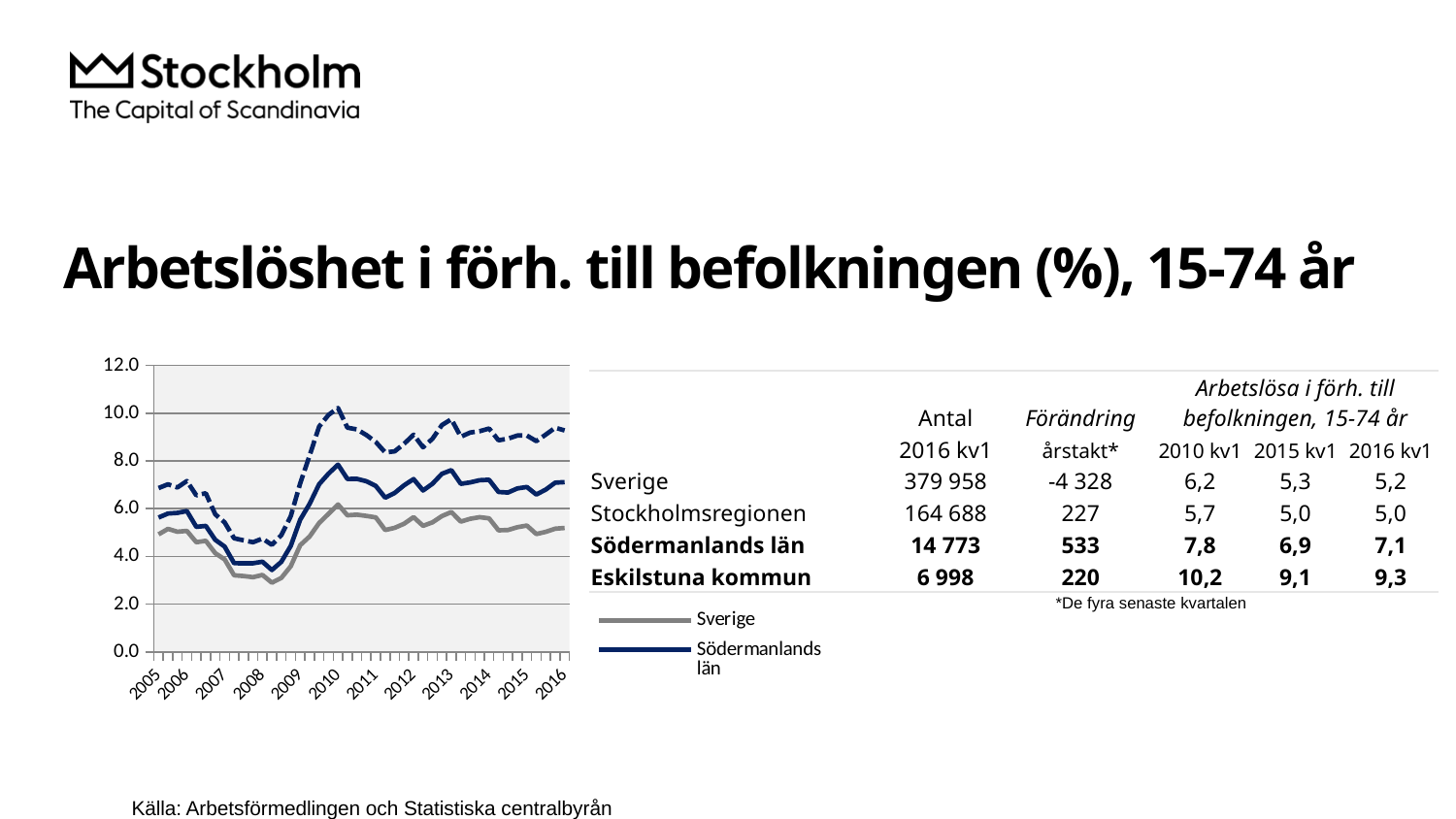
Which series does the chart legend list besides Sverige? Södermanlands län How many series does the chart legend list? 2 What kind of chart is shown on the left of the slide? line chart Is the value for Sverige in 2010 greater or less than 4.0? greater What colour is the Sverige line in the chart? grey What is the highest value shown on the chart's vertical axis? 12.0 Around which year does the Sverige line reach its highest point? 2010 Is the value for Södermanlands län in 2010 greater or less than 6.0? greater In 2016, which line is higher, Sverige or Södermanlands län? Södermanlands län Does the Sverige line rise or fall between 2008 and 2010? rise Is the value for Södermanlands län in 2008 greater or less than 6.0? less